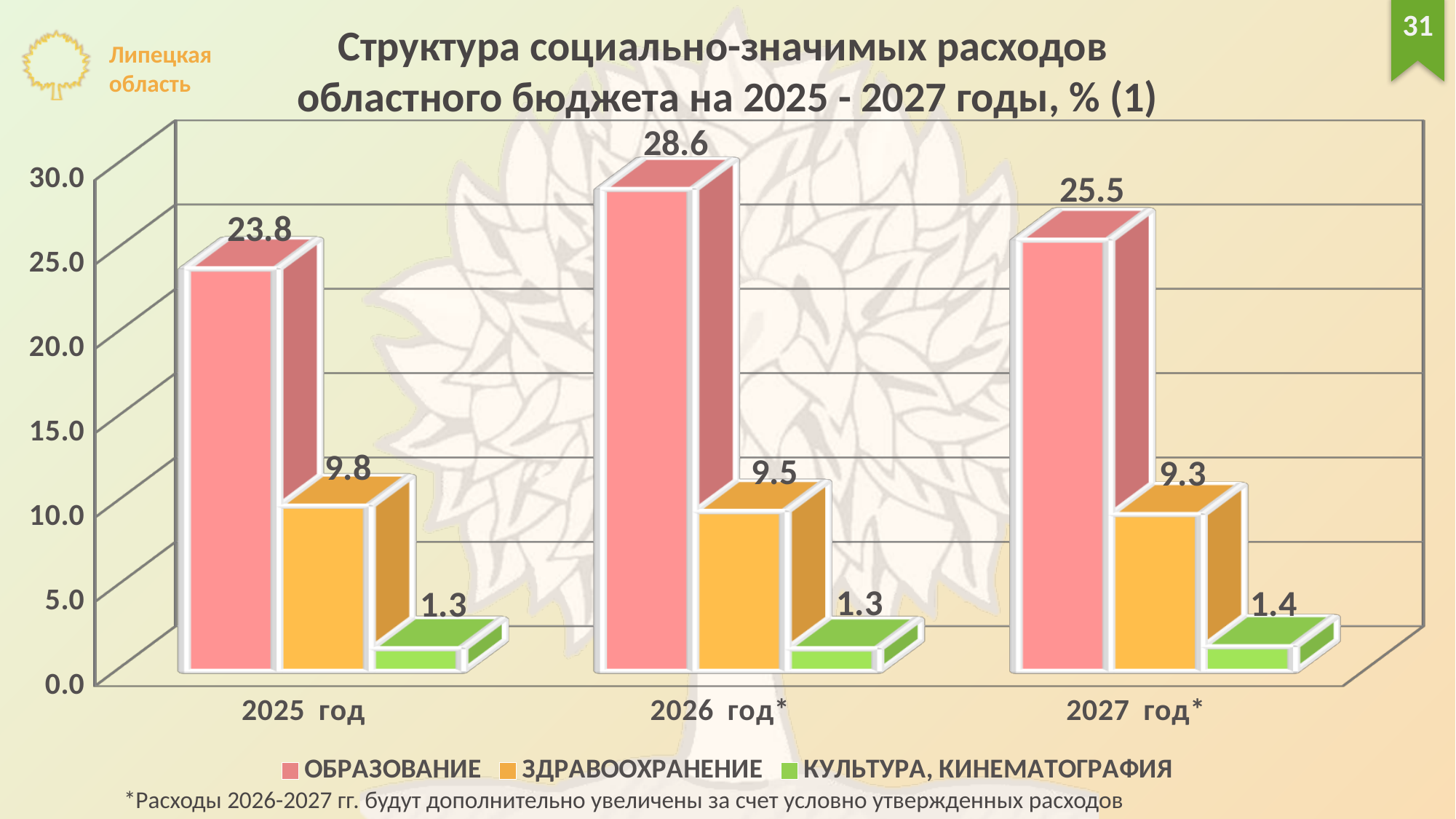
Which is larger: ОБРАЗОВАНИЕ in 2027 год* or ОБРАЗОВАНИЕ in 2025 год? ОБРАЗОВАНИЕ in 2027 год* How many series does the legend list? 3 What kind of chart is shown on the slide? bar chart What is the value for КУЛЬТУРА, КИНЕМАТОГРАФИЯ in 2027 год*? 1.4 In which year is the value for ЗДРАВООХРАНЕНИЕ lowest? 2027 год* What is the value for ЗДРАВООХРАНЕНИЕ in 2025 год? 9.8 How many year categories are shown on the x axis? 3 What is the value for ОБРАЗОВАНИЕ in 2026 год*? 28.6 What is the difference between the ОБРАЗОВАНИЕ values for 2026 год* and 2025 год? 4.8 Which colour represents ЗДРАВООХРАНЕНИЕ in the legend? orange In which year is the value for ОБРАЗОВАНИЕ highest? 2026 год* Is the value for ЗДРАВООХРАНЕНИЕ in 2026 год* greater or less than 10.0? less